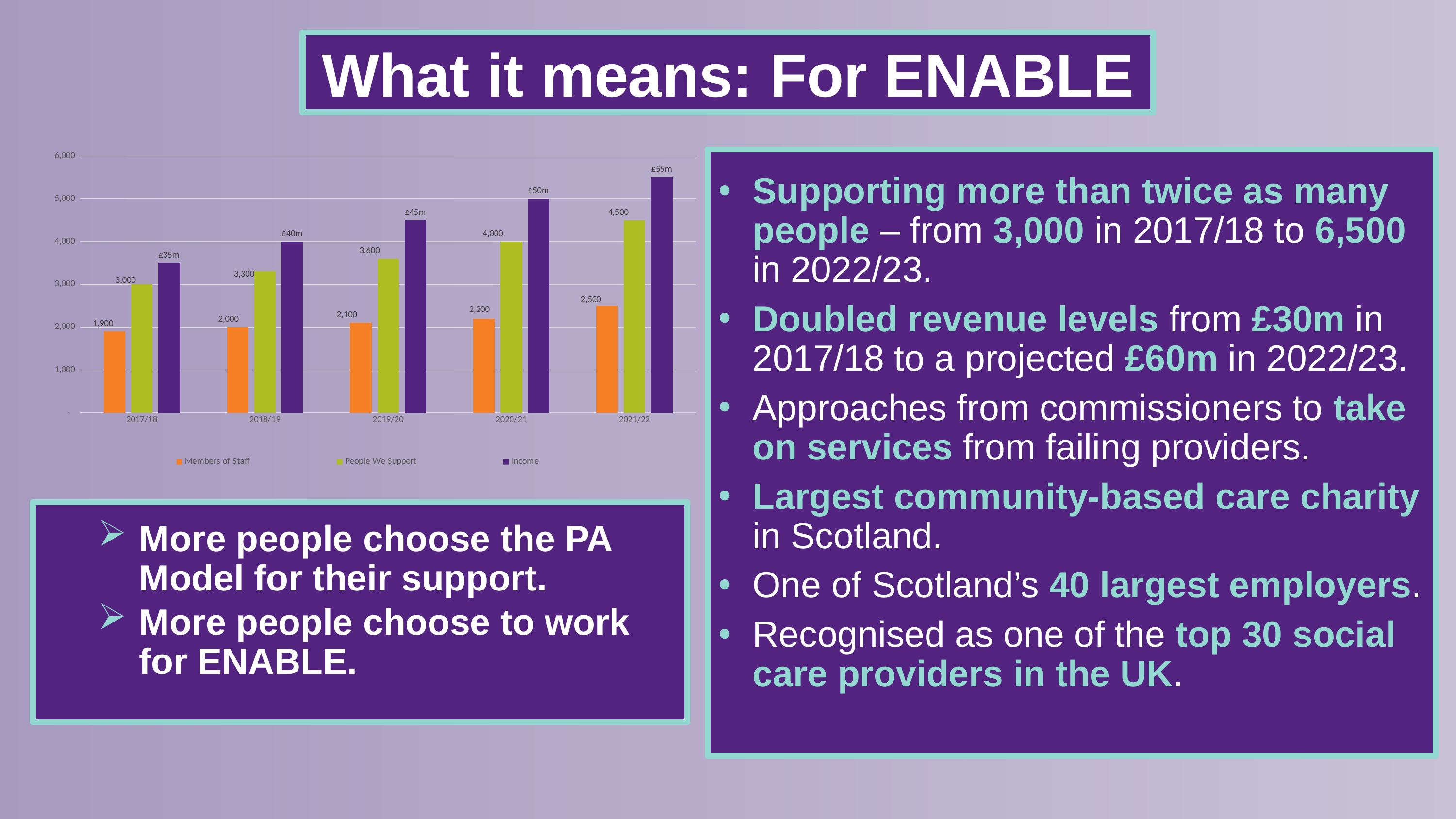
Which year has the highest value for Members of Staff? 2021/22 Which is larger: Members of Staff in 2020/21 or Members of Staff in 2018/19? 2020/21 Which year has the lowest value for People We Support? 2017/18 Do the People We Support values rise or fall from 2017/18 to 2021/22? rise What is the Income data label for 2021/22? £55m What is the value for People We Support in 2019/20? 3,600 How many years are shown on the x axis? 5 How many series does the legend list? 3 What kind of chart is shown on the slide? bar chart What is the difference between People We Support in 2021/22 and 2017/18? 1,500 What is the value for Members of Staff in 2017/18? 1,900 What is the value for People We Support in 2021/22? 4,500